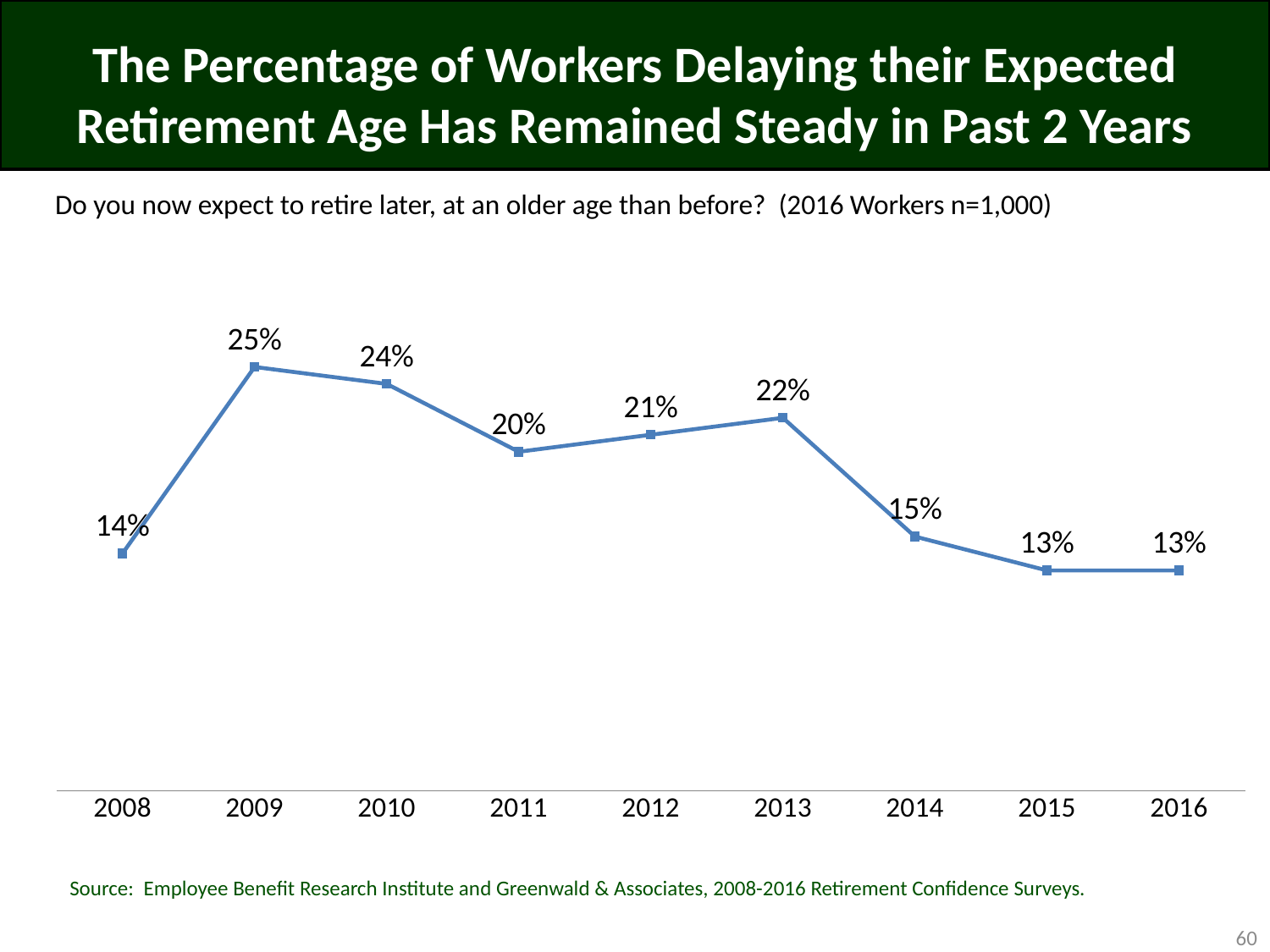
Which year has the highest percentage of workers delaying their expected retirement age? 2009 What is the value shown for 2008? 14% What is the difference between the values for 2009 and 2016? 12 percentage points How many years are plotted on the chart? 9 What percentage of workers expected to retire later in 2009? 25% What is the difference between the values for 2013 and 2014? 7 percentage points What is the value shown for 2014? 15% Which year has a higher value, 2010 or 2012? 2010 What is the lowest value plotted on the chart? 13% What kind of chart is shown on the slide? Line chart Did the value rise or fall from 2013 to 2015? Fall What survey question is the chart based on, as shown above the chart? Do you now expect to retire later, at an older age than before?